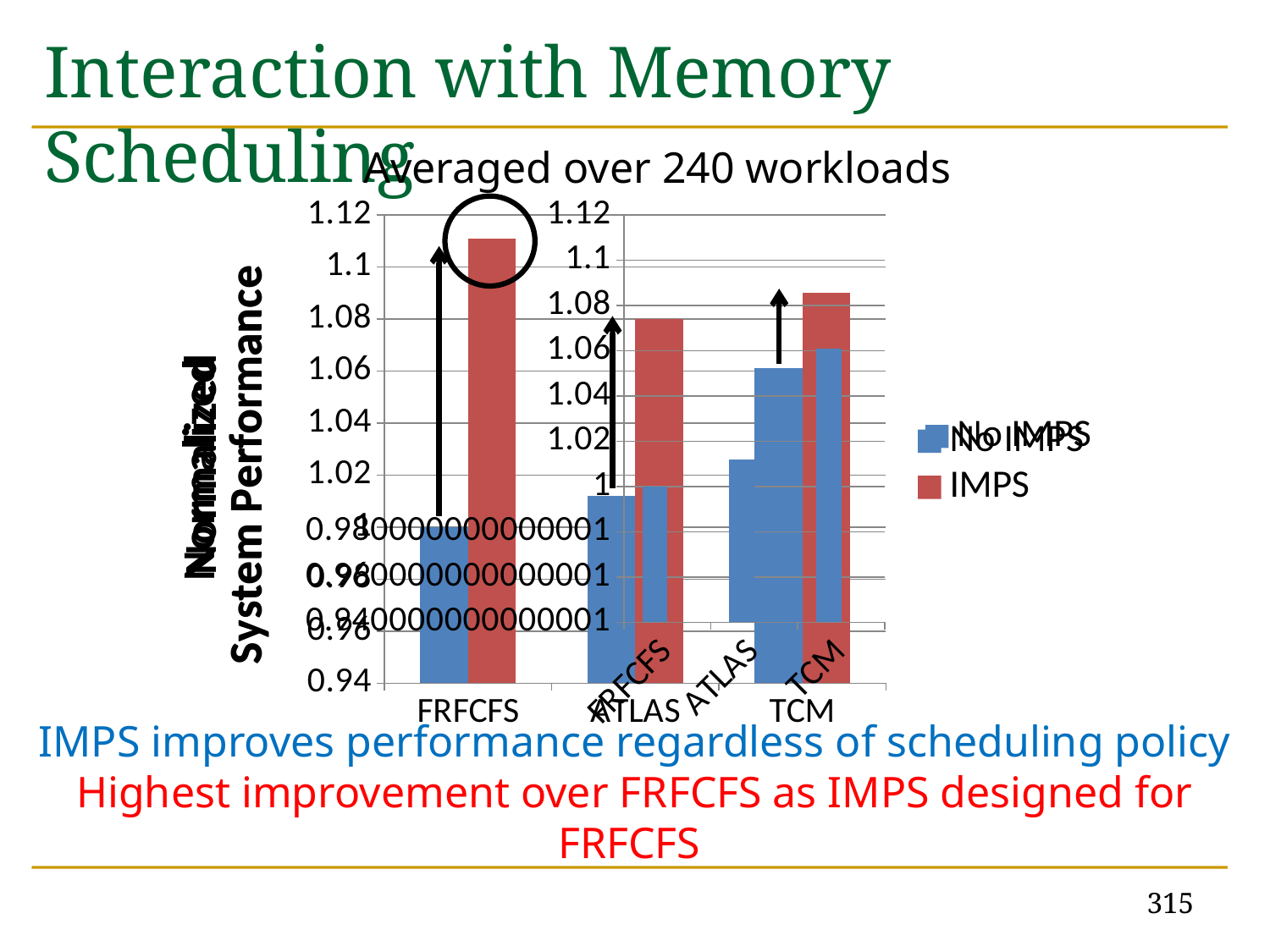
What is the title of the chart? Averaged over 240 workloads Do the No IMPS bars rise or fall from FRFCFS to TCM along the x axis? rise Is the No IMPS value for FRFCFS greater or less than 1.02? less Which scheduling policy has the highest No IMPS bar? TCM Which scheduling policy has the highest IMPS bar? FRFCFS How many scheduling policies (categories) are shown on the x axis of the chart? 3 What kind of chart is shown on the slide? bar chart How many series does the chart legend list? 2 Is the IMPS value for FRFCFS greater or less than 1.1? greater For TCM, which is larger: the IMPS bar or the No IMPS bar? IMPS Which colour represents the IMPS series in the chart? red For FRFCFS, which is larger: the IMPS bar or the No IMPS bar? IMPS